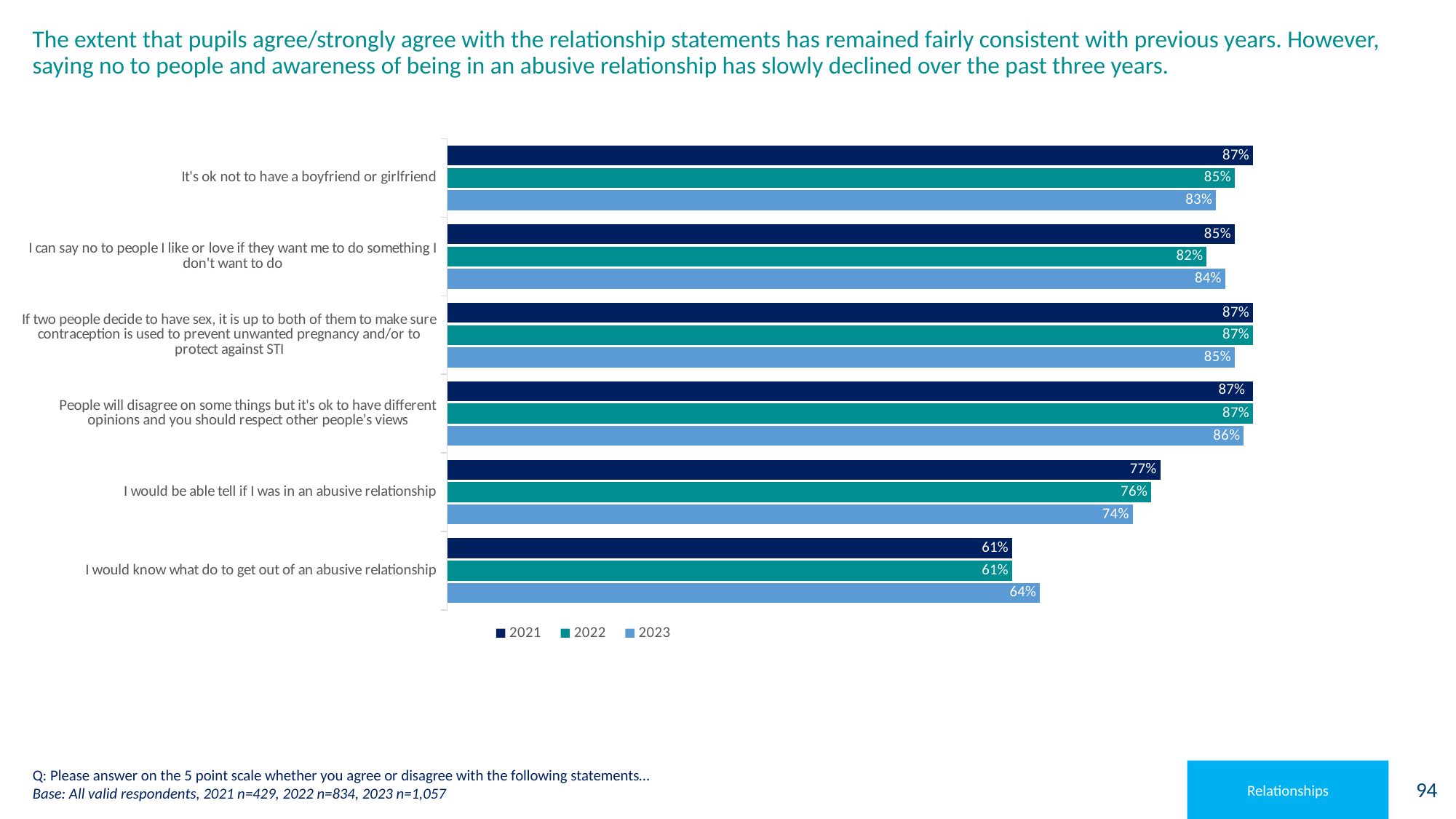
Which statement has the lowest 2021 value? I would know what do to get out of an abusive relationship What is the 2021 value for "I would be able tell if I was in an abusive relationship"? 77% What kind of chart is shown on the slide? Bar chart What is the 2022 value for "I can say no to people I like or love if they want me to do something I don't want to do"? 82% Which is larger for "I would know what do to get out of an abusive relationship": the 2021 value or the 2023 value? 2023 Do the values for "It's ok not to have a boyfriend or girlfriend" rise or fall from 2021 to 2023? Fall What is the 2023 value for "It's ok not to have a boyfriend or girlfriend"? 83% What is the difference between the 2021 and 2023 values for "I would be able tell if I was in an abusive relationship"? 3% Which year does the lightest blue bar represent in the legend? 2023 How many statements (categories) are shown on the chart? 6 How many series does the legend list? 3 What is the 2023 value for "I would know what do to get out of an abusive relationship"? 64%